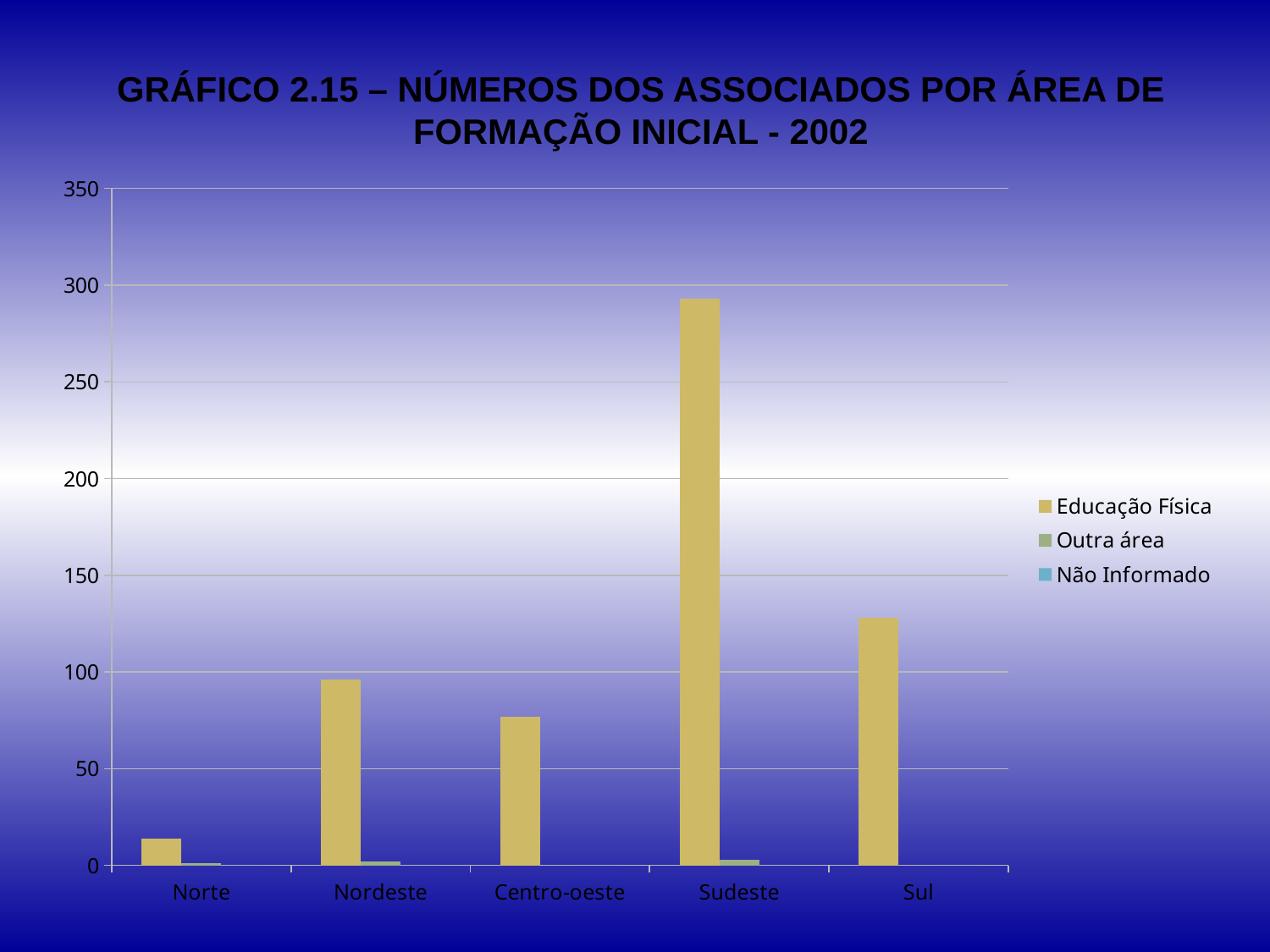
Is the Educação Física value for Sul greater or less than 100? greater Is the Educação Física value for Norte greater or less than 50? less How many regions are shown on the x axis? 5 Which region has the highest value for Educação Física? Sudeste Which is larger for Educação Física: Nordeste or Centro-oeste? Nordeste Which region has the lowest value for Educação Física? Norte How many series does the legend list? 3 Is the Educação Física value for Centro-oeste greater or less than 100? less What kind of chart is shown on the slide? bar chart Which is larger for Educação Física: Sul or Nordeste? Sul Which series is shown in the legend with a yellow/gold colour? Educação Física